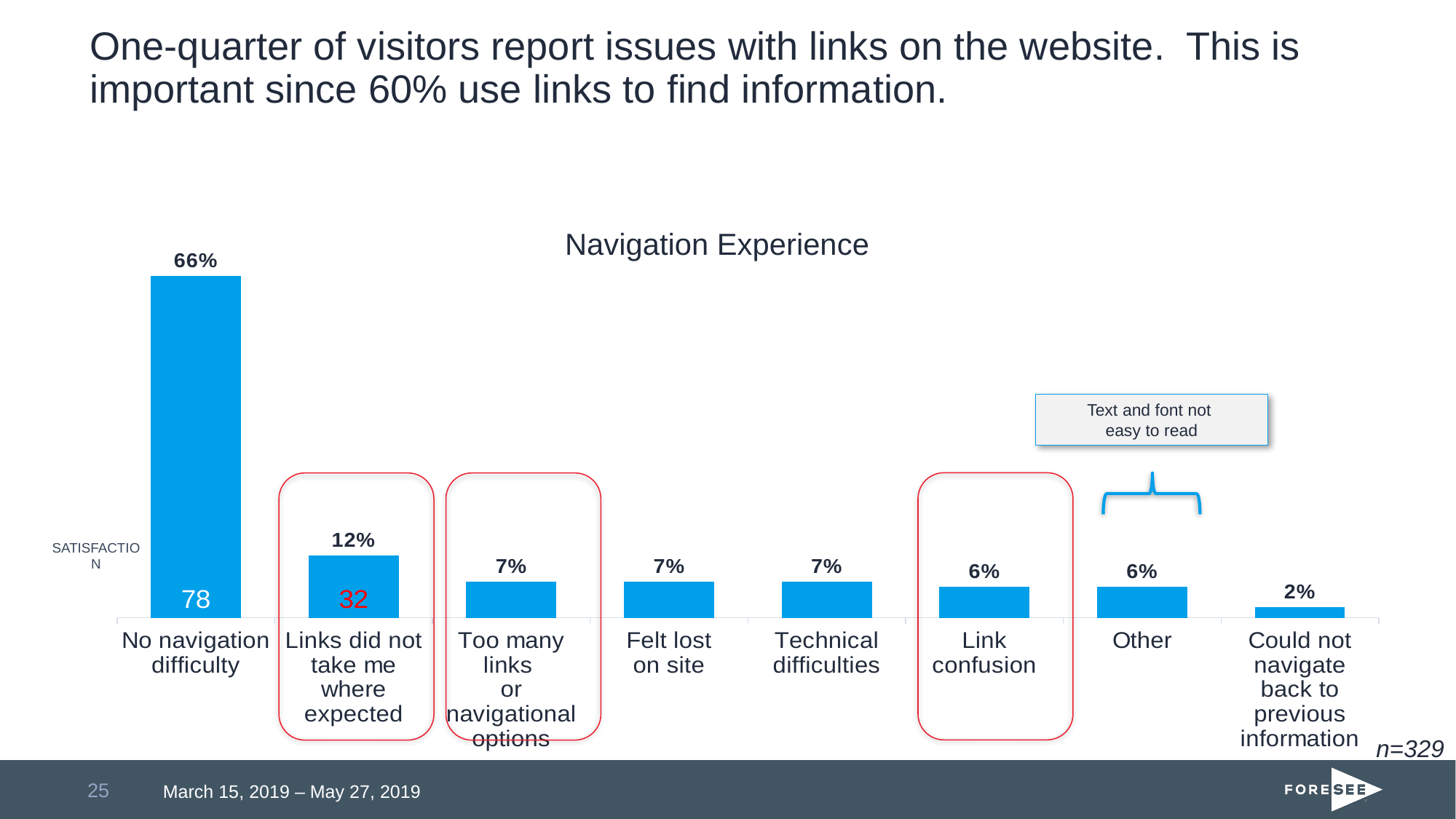
What satisfaction score is printed inside the 'Links did not take me where expected' bar? 32 What percentage of visitors reported 'Links did not take me where expected'? 12% What type of chart is shown on the slide? Bar chart Which category has the lowest percentage? Could not navigate back to previous information What is the difference in percentage points between 'No navigation difficulty' and 'Links did not take me where expected'? 54 What percentage of visitors reported 'Link confusion'? 6% What is the title of the chart? Navigation Experience Which category has the highest percentage? No navigation difficulty What percentage of visitors reported 'Could not navigate back to previous information'? 2% How many categories are shown in the chart? 8 Which is larger, the value for 'Felt lost on site' or the value for 'Other'? Felt lost on site What percentage of visitors reported 'No navigation difficulty'? 66%